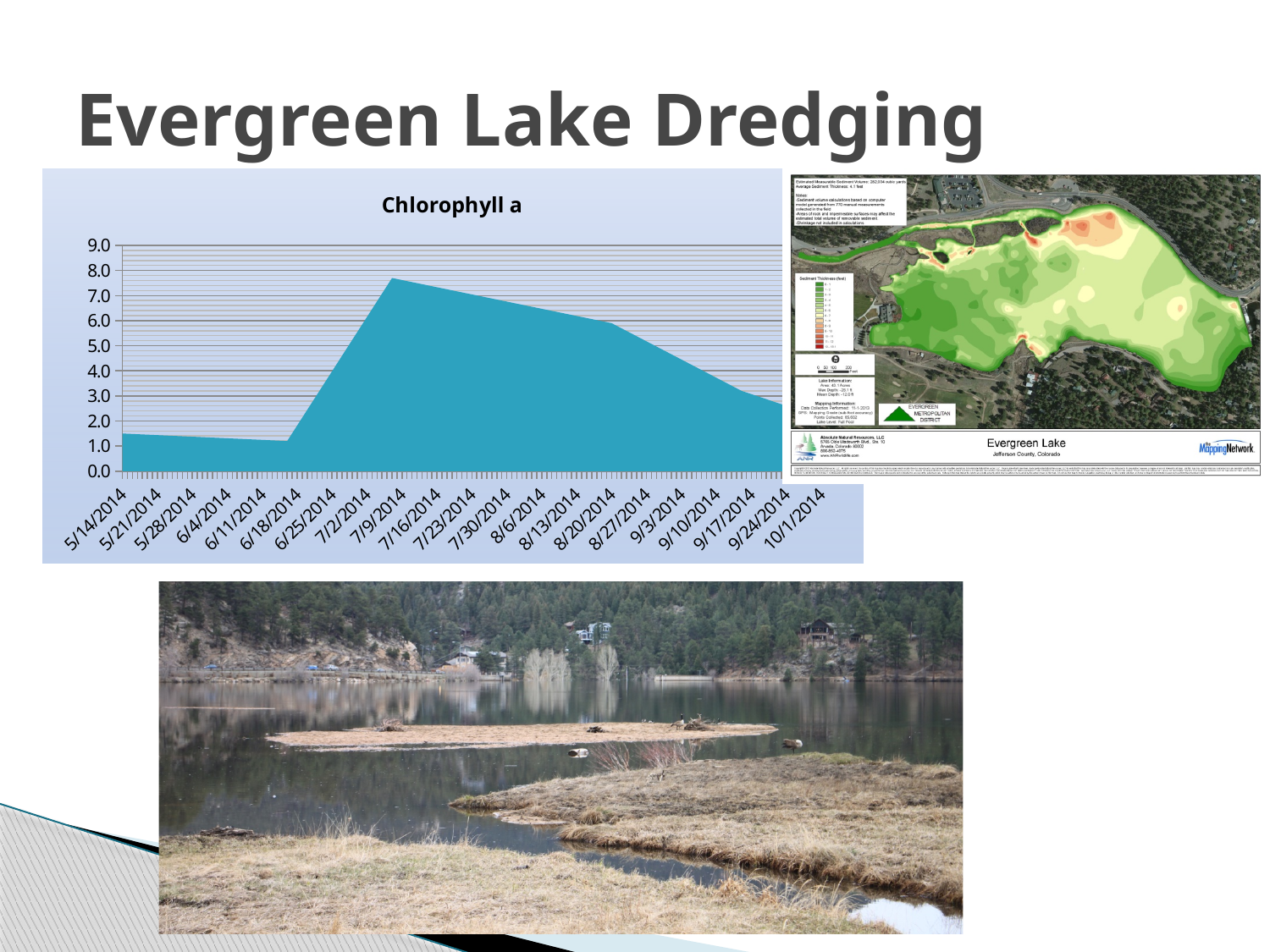
What is the highest value shown on the y axis of the Chlorophyll a chart? 9.0 Is the Chlorophyll a value for 7/9/2014 greater or less than 7.0? greater Do the Chlorophyll a values rise or fall between 7/9/2014 and 10/1/2014? fall Which date has the larger Chlorophyll a value, 7/9/2014 or 10/1/2014? 7/9/2014 Do the Chlorophyll a values rise or fall between 6/18/2014 and 7/9/2014? rise Is the Chlorophyll a value for 8/13/2014 greater or less than 5.0? greater How many dates are labelled on the x axis of the Chlorophyll a chart? 21 What kind of chart is the Chlorophyll a chart? area chart What is the title of the chart on the slide? Chlorophyll a Is the Chlorophyll a value for 10/1/2014 greater or less than 3.0? less